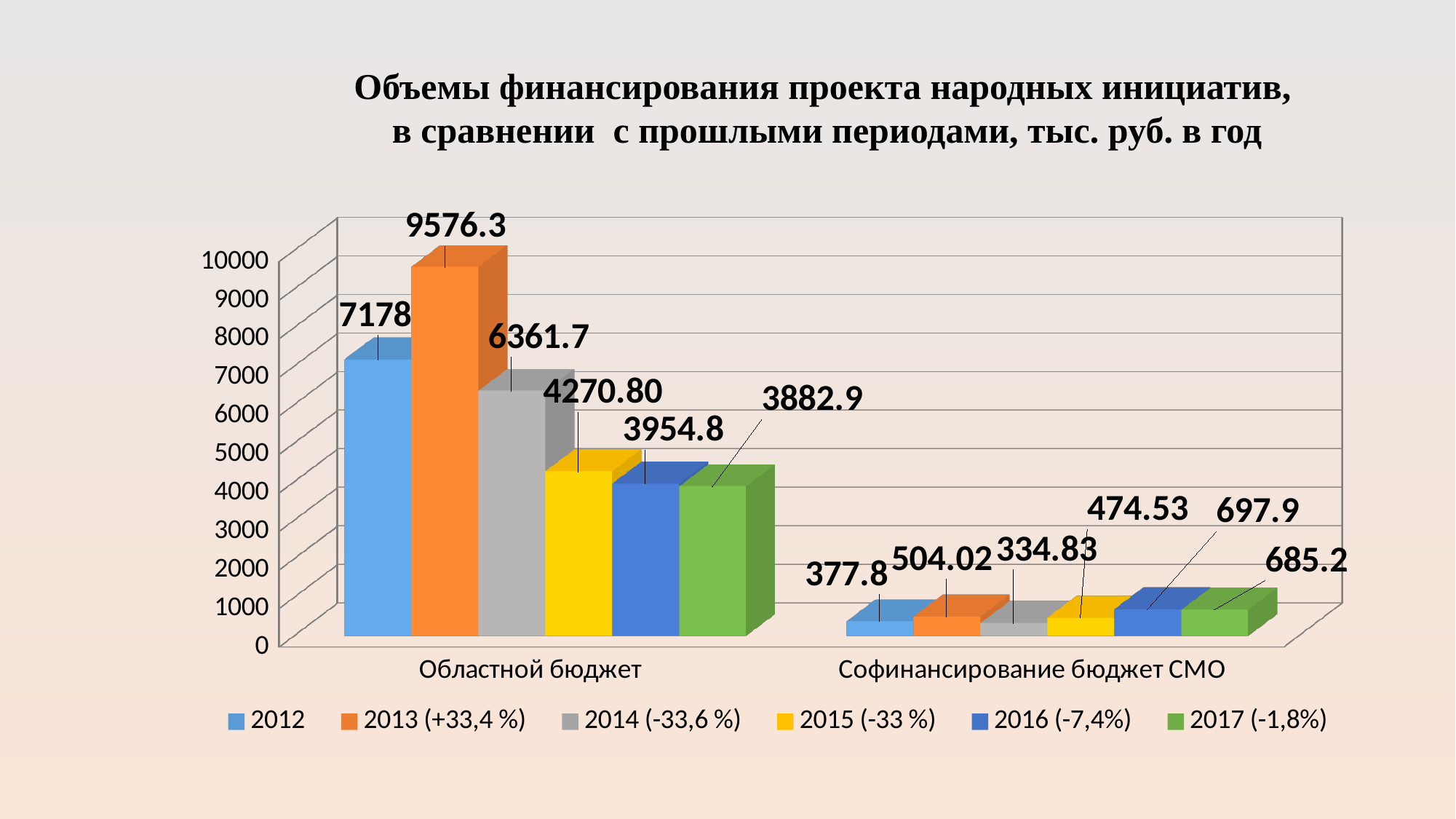
What is the value for 2012 in the Областной бюджет category? 7178 What is the value for 2013 in the Областной бюджет category? 9576.3 In the Софинансирование бюджет СМО category, which is larger: the value for 2015 or the value for 2012? 2015 How many series does the legend list? 6 Which year has the lowest value in the Софинансирование бюджет СМО category? 2014 What is the value for 2014 in the Софинансирование бюджет СМО category? 334.83 Which legend entry is shown in orange? 2013 (+33,4 %) How many categories are shown on the x axis? 2 What is the difference between the 2013 and 2012 values in the Областной бюджет category? 2398.3 What is the value for 2016 in the Софинансирование бюджет СМО category? 697.9 What type of chart is shown on the slide? Bar chart Which year has the highest value in the Областной бюджет category? 2013